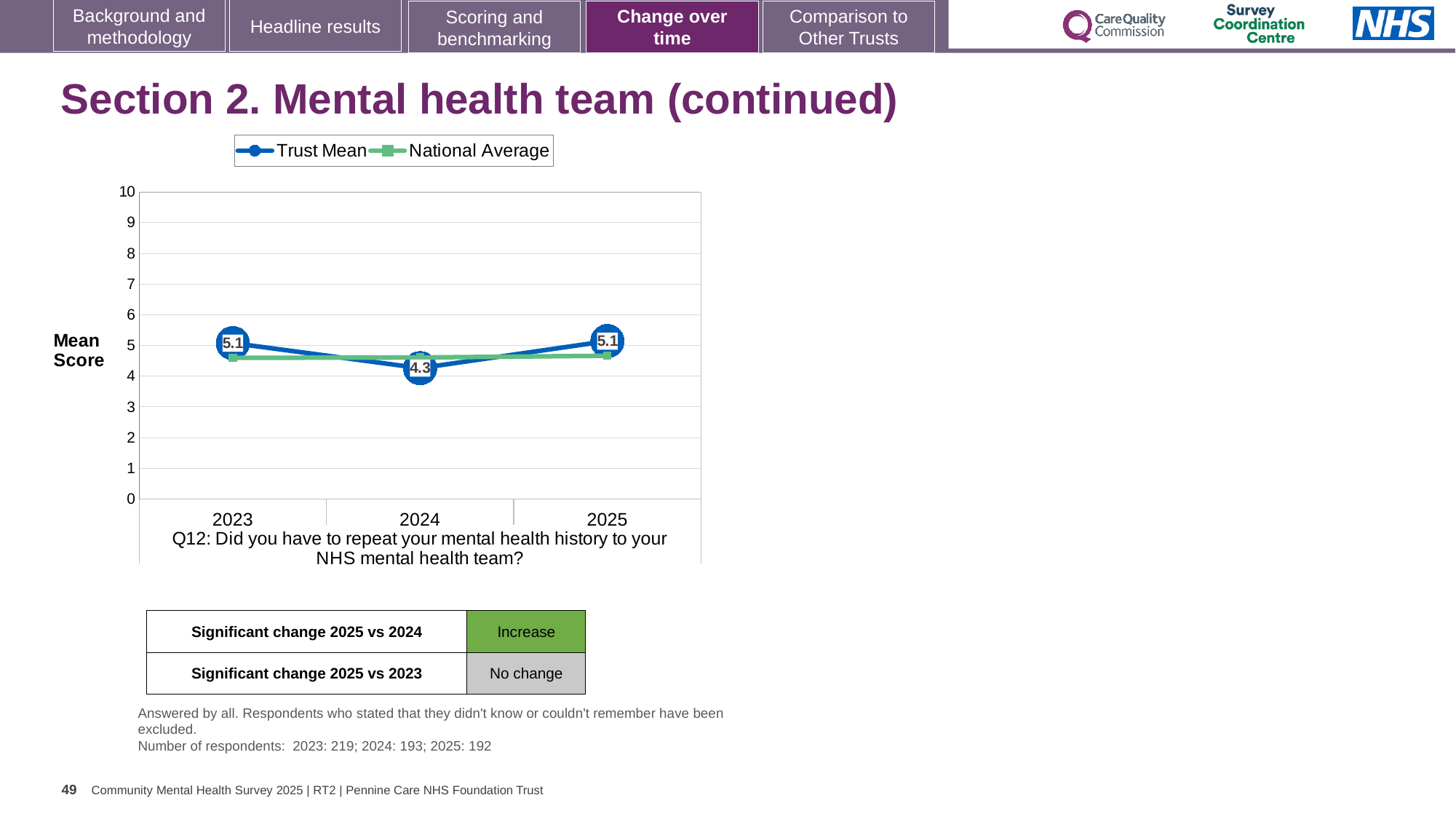
In which year is the Trust Mean score lowest? 2024 What is the Trust Mean score for 2023? 5.1 Is the National Average value for 2024 greater or less than 5? less How many series does the legend list? 2 In 2024, which series has the higher value, Trust Mean or National Average? National Average What is the Trust Mean score for 2024? 4.3 What kind of chart is shown on the slide? line chart How does the Trust Mean score change from 2023 to 2024 to 2025? falls then rises What is the Trust Mean score for 2025? 5.1 How many years are plotted on the x axis? 3 What is the difference between the Trust Mean score in 2025 and in 2024? 0.8 Which is larger, the Trust Mean score in 2023 or in 2024? 2023